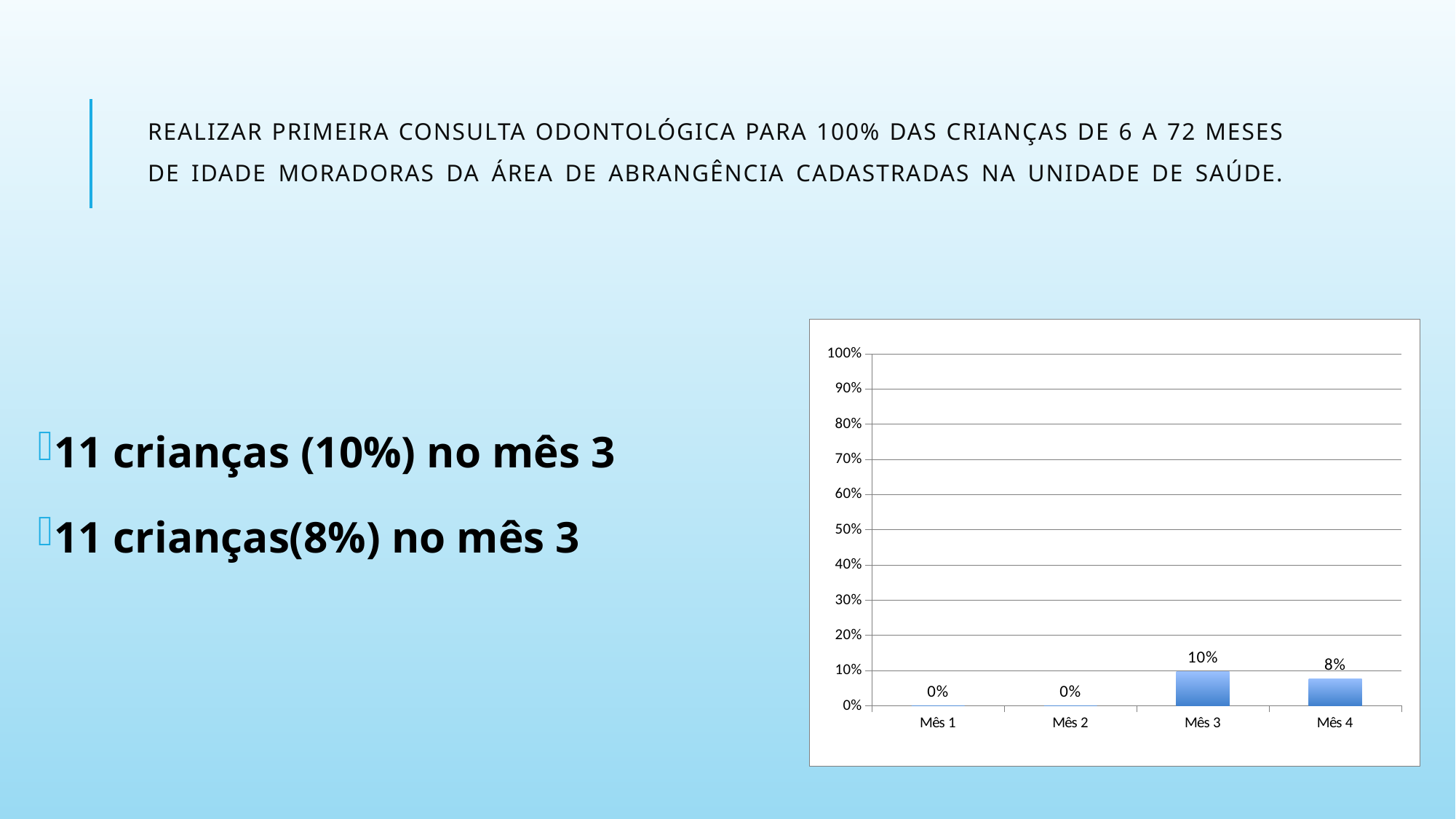
What is the value for Mês 2? 0% Which is larger, the value for Mês 3 or the value for Mês 4? Mês 3 Which month has the highest value? Mês 3 Is the value for Mês 3 greater or less than 50%? less What is the value for Mês 3? 10% What is the highest value shown on the y axis? 100% What is the value for Mês 4? 8% What is the value for Mês 1? 0% What is the difference between the values for Mês 3 and Mês 4? 2% How many months have a value of 0%? 2 What kind of chart is shown on the slide? bar chart How many months are shown on the x axis? 4